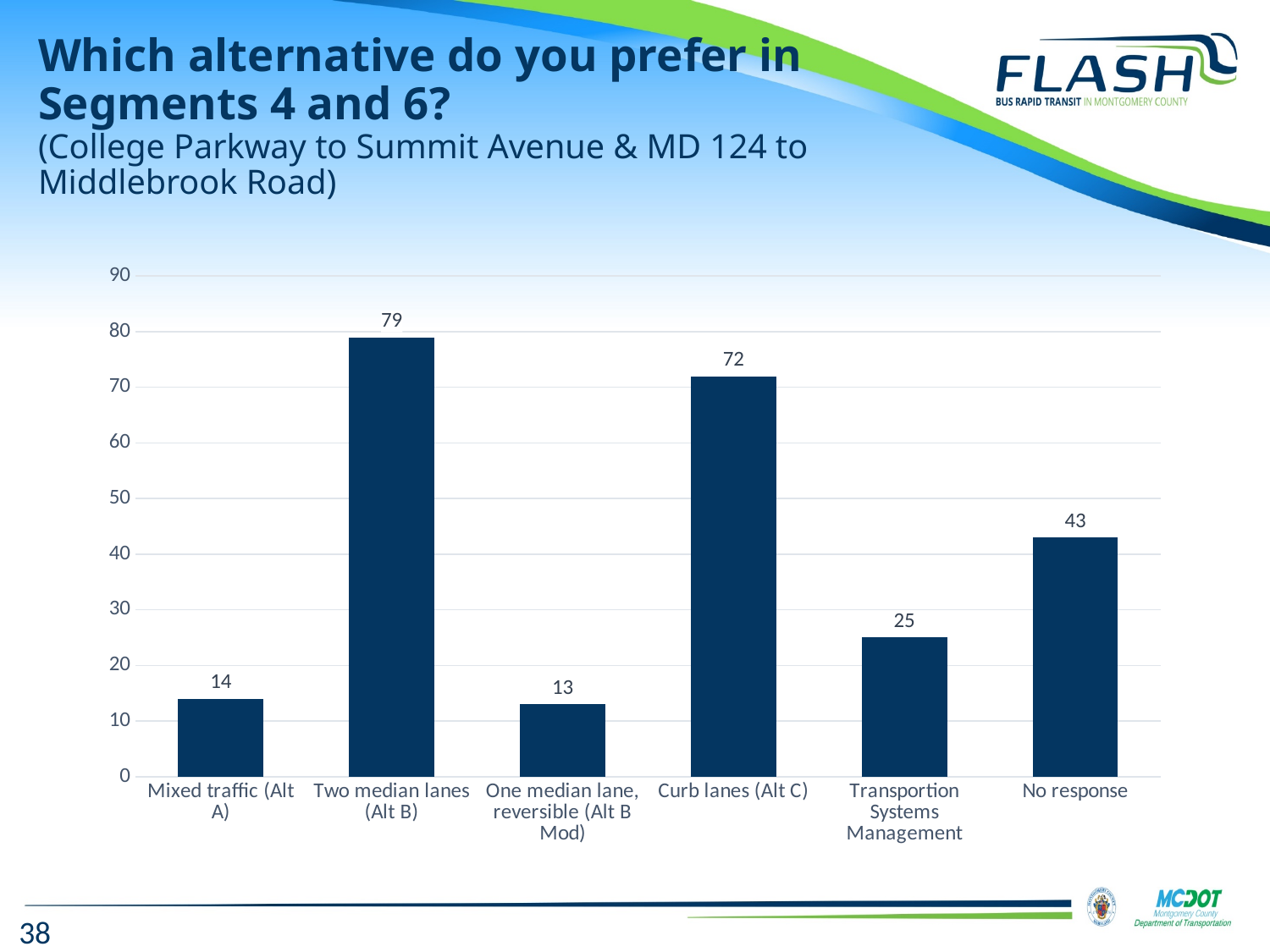
What is the value for No response? 43 Which is larger, the value for Mixed traffic (Alt A) or the value for Transportion Systems Management? Transportion Systems Management What is the value for Transportion Systems Management? 25 What is the value for Curb lanes (Alt C)? 72 What kind of chart is shown on the slide? bar chart Is the value for No response greater or less than 50? less What is the difference between the values for Mixed traffic (Alt A) and One median lane, reversible (Alt B Mod)? 1 What is the difference between the values for Two median lanes (Alt B) and Curb lanes (Alt C)? 7 Which category has the lowest value? One median lane, reversible (Alt B Mod) Which category has the highest value? Two median lanes (Alt B) How many categories are shown on the x axis? 6 What is the value for Two median lanes (Alt B)? 79